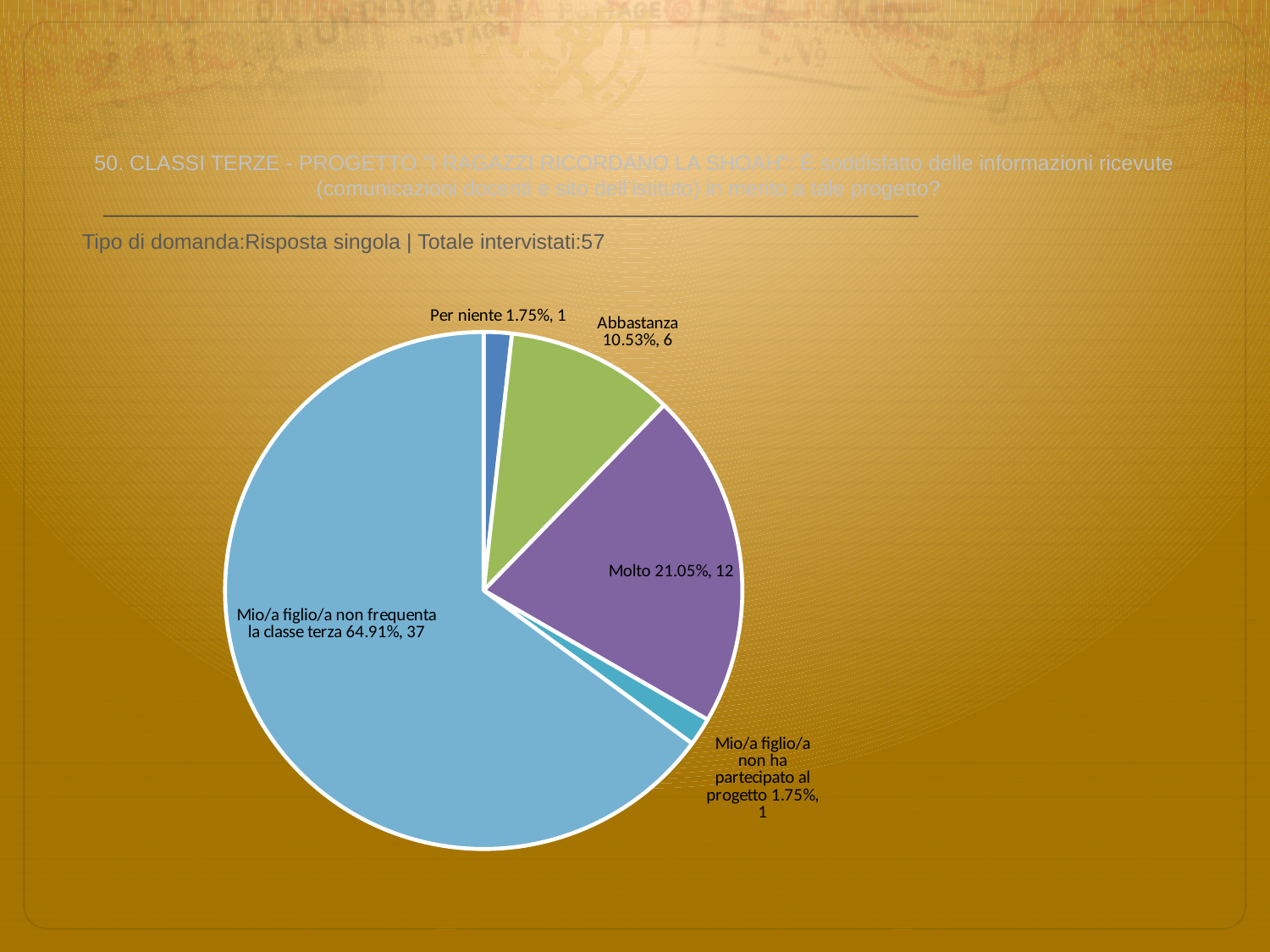
What percentage share does the 'Molto' slice have? 21.05% What kind of chart is shown on the slide? pie chart How many slices does the pie chart have? 5 What is the count for 'Mio/a figlio/a non frequenta la classe terza'? 37 What percentage share does the 'Per niente' slice have? 1.75% Which is larger, the 'Abbastanza' slice or the 'Molto' slice? Molto What is the total number of respondents shown on the slide? 57 What is the difference in count between 'Molto' and 'Abbastanza'? 6 Which category has the largest slice? Mio/a figlio/a non frequenta la classe terza How many respondents answered 'Abbastanza'? 6 What colour is the 'Molto' slice? purple How many respondents answered 'Mio/a figlio/a non ha partecipato al progetto'? 1